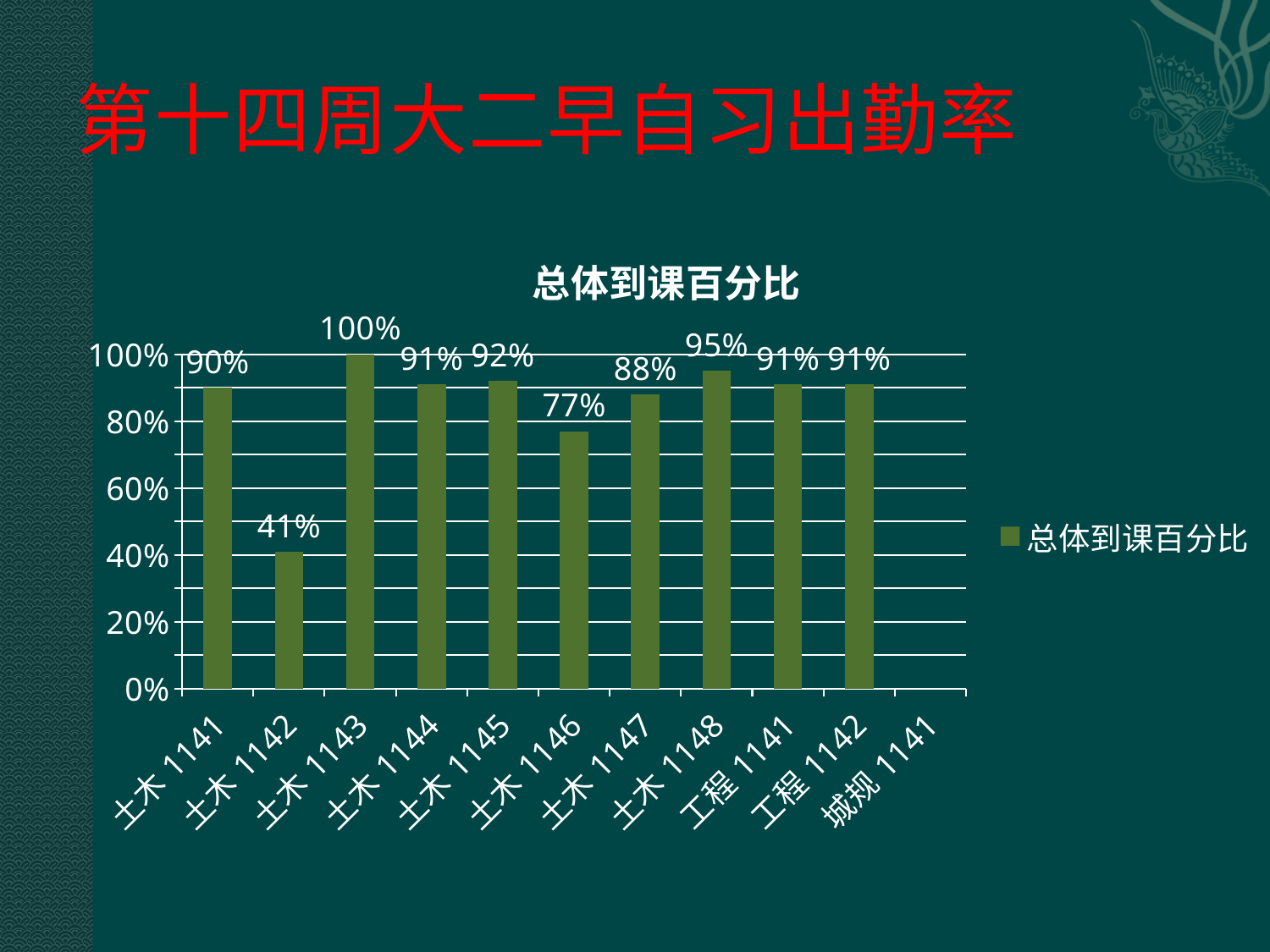
What kind of chart is shown? bar chart Which category has the lowest value? 土木1142 Which is larger, the value for 土木1145 or the value for 土木1146? 土木1145 What is the title of the chart? 总体到课百分比 What is the value for 土木1148? 95% What is the value for 工程1142? 91% What is the difference between the values for 土木1143 and 土木1142? 59% What is the value for 土木1146? 77% How many bars are plotted in the chart? 10 Which category has the highest value? 土木1143 What is the value for 土木1142? 41% What is the difference between the values for 土木1148 and 土木1147? 7%